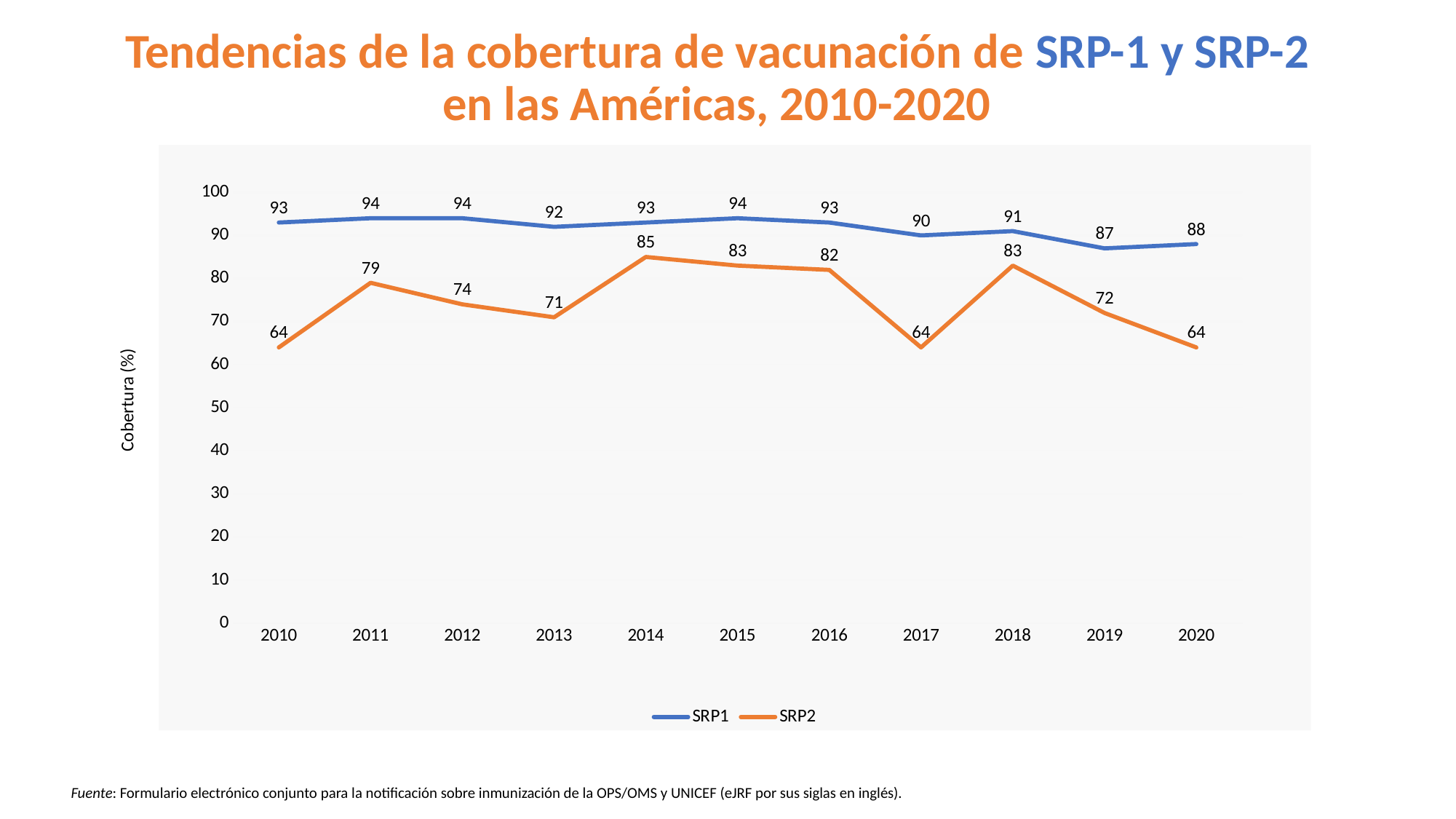
What is the SRP2 coverage value for 2020? 64 How many series does the legend list? 2 What is the SRP2 coverage value for 2014? 85 What is the label of the y axis? Cobertura (%) What is the SRP1 coverage value for 2015? 94 How many years are shown on the x axis? 11 In which year is the SRP2 coverage highest? 2014 What kind of chart is shown on the slide? Line chart Is the SRP2 value for 2013 greater or less than 80? less What is the difference between SRP1 and SRP2 coverage in 2017? 26 In which year is the SRP1 coverage lowest? 2019 Which series has the higher value in 2018, SRP1 or SRP2? SRP1